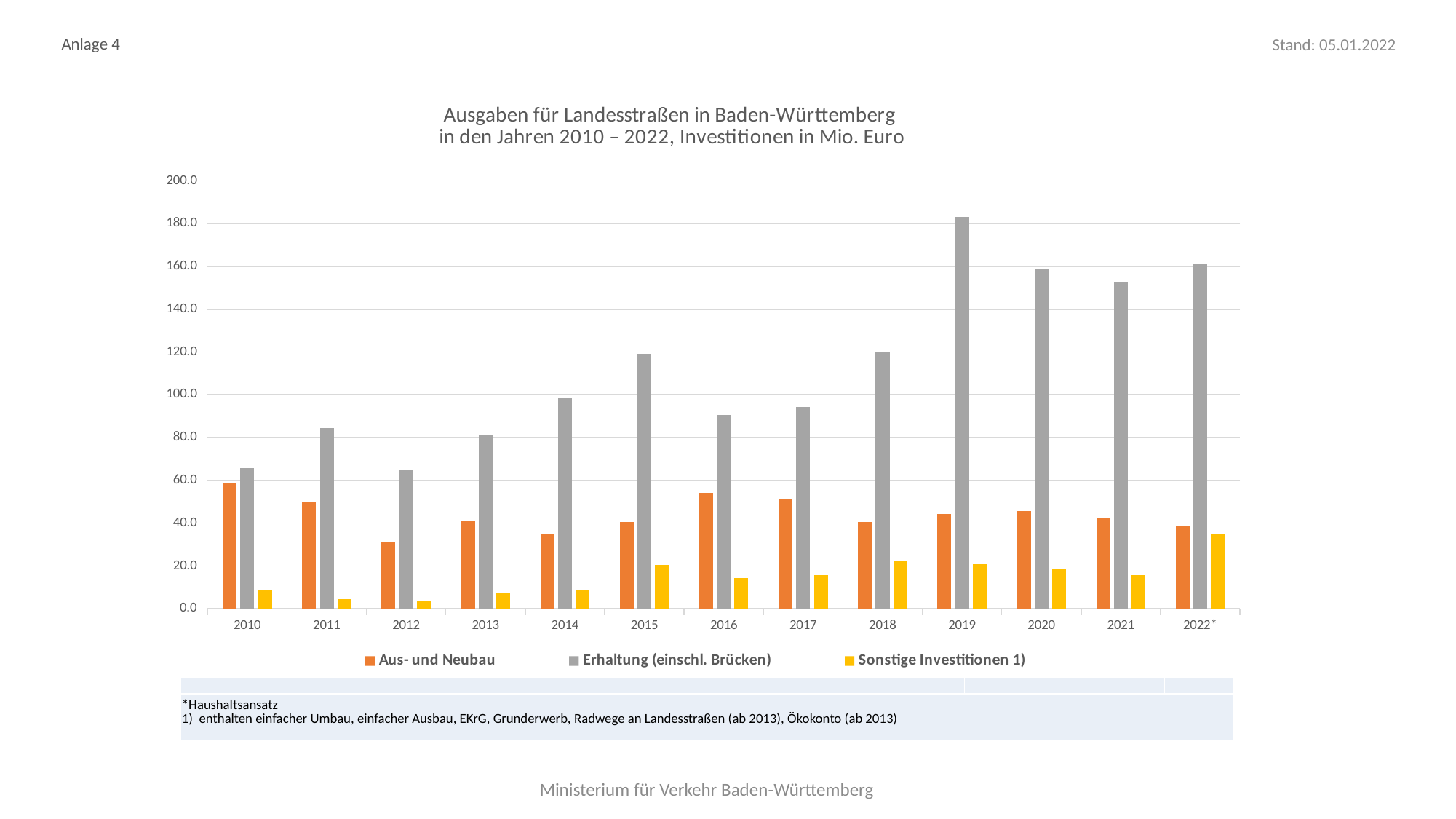
Is the value for Aus- und Neubau in 2012 greater or less than 40? less In which year is the value for Aus- und Neubau highest? 2010 In which year is the value for Sonstige Investitionen 1) highest? 2022* Which is larger: Erhaltung (einschl. Brücken) in 2017 or in 2018? 2018 How many series does the legend list? 3 What colour are the bars for Erhaltung (einschl. Brücken)? grey Does the value for Erhaltung (einschl. Brücken) rise or fall from 2019 to 2021? fall Is the value for Erhaltung (einschl. Brücken) in 2019 greater or less than 160? greater Is the value for Sonstige Investitionen 1) in 2022* greater or less than 20? greater What kind of chart is shown on the slide? bar chart How many years are shown on the x axis? 13 In which year is the value for Erhaltung (einschl. Brücken) highest? 2019